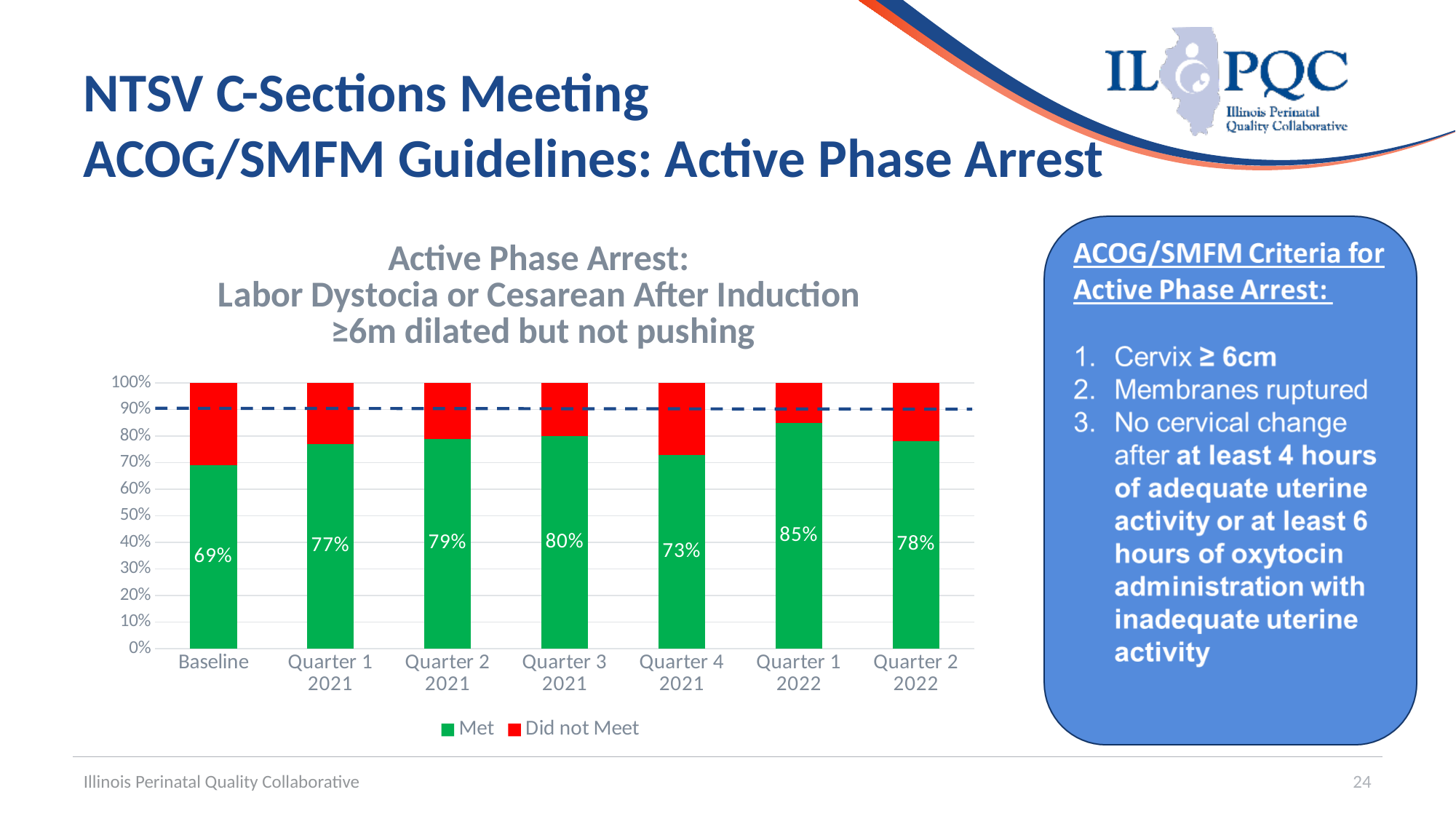
At what value is the horizontal dashed line drawn? 90% Which category has the highest Met value? Quarter 1 2022 Which is larger, the Met value for Quarter 3 2021 or the Met value for Quarter 2 2022? Quarter 3 2021 Is the Met value for Quarter 2 2021 greater or less than 70%? greater What is the Met value for Baseline? 69% What kind of chart is shown? Stacked bar chart What is the difference between the Met value for Quarter 1 2022 and the Met value for Baseline? 16% How many categories are shown on the x axis? 7 Which category has the lowest Met value? Baseline What is the Met value for Quarter 4 2021? 73% What is the Met value for Quarter 1 2022? 85% How many series does the legend list? 2